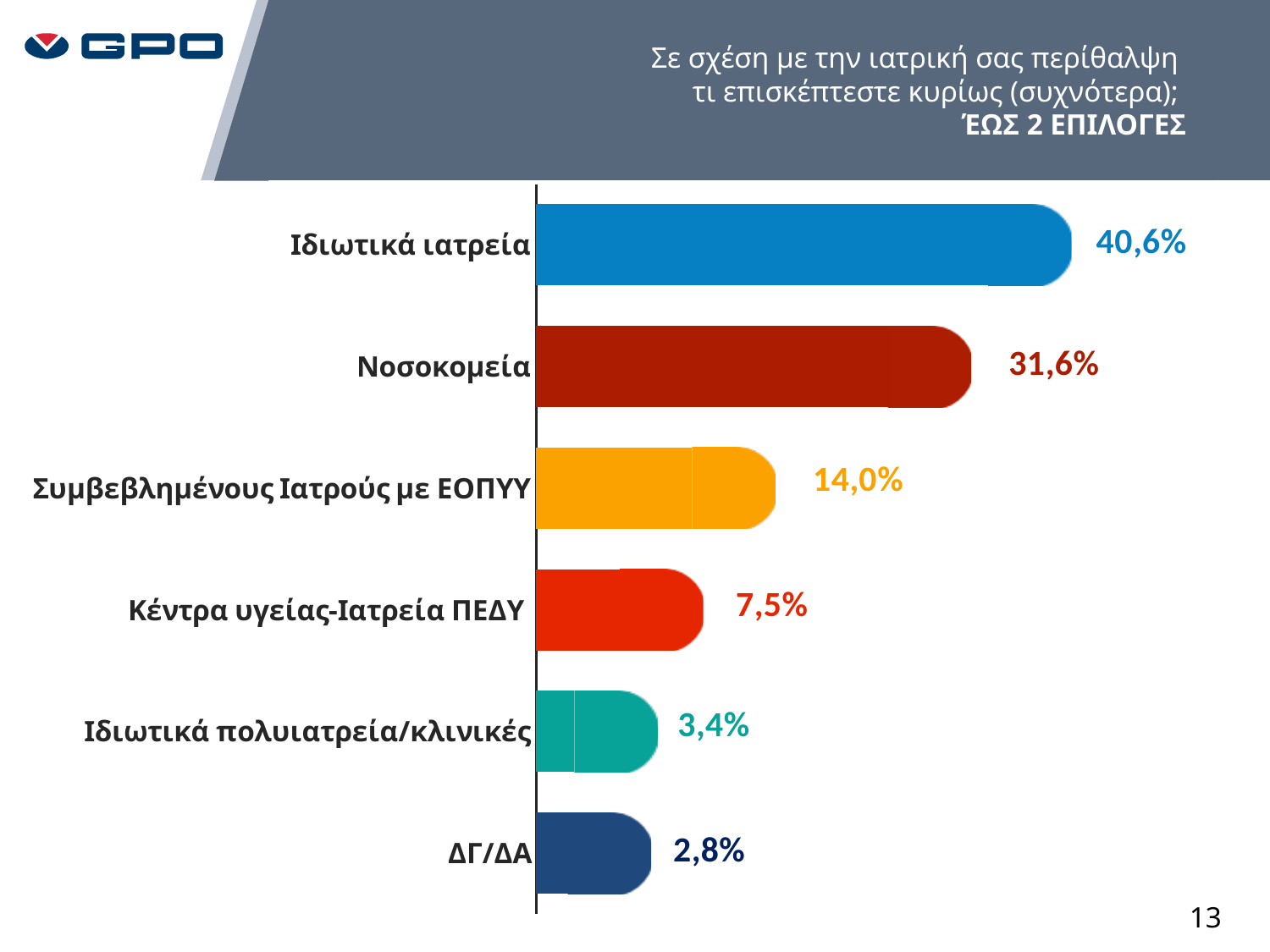
How many categories are shown in the chart? 6 Which category has the highest value? Ιδιωτικά ιατρεία What is the value for Ιδιωτικά ιατρεία? 40,6% What is the value for ΔΓ/ΔΑ? 2,8% What is the value for Κέντρα υγείας-Ιατρεία ΠΕΔΥ? 7,5% What is the value for Συμβεβλημένους Ιατρούς με ΕΟΠΥΥ? 14,0% Which category has the lowest value? ΔΓ/ΔΑ What is the value for Νοσοκομεία? 31,6% What is the difference between the values for Ιδιωτικά ιατρεία and Νοσοκομεία? 9,0% Which is larger, the value for Κέντρα υγείας-Ιατρεία ΠΕΔΥ or the value for Ιδιωτικά πολυιατρεία/κλινικές? Κέντρα υγείας-Ιατρεία ΠΕΔΥ What kind of chart is shown on the slide? Bar chart What colour is the bar for Νοσοκομεία? Dark red